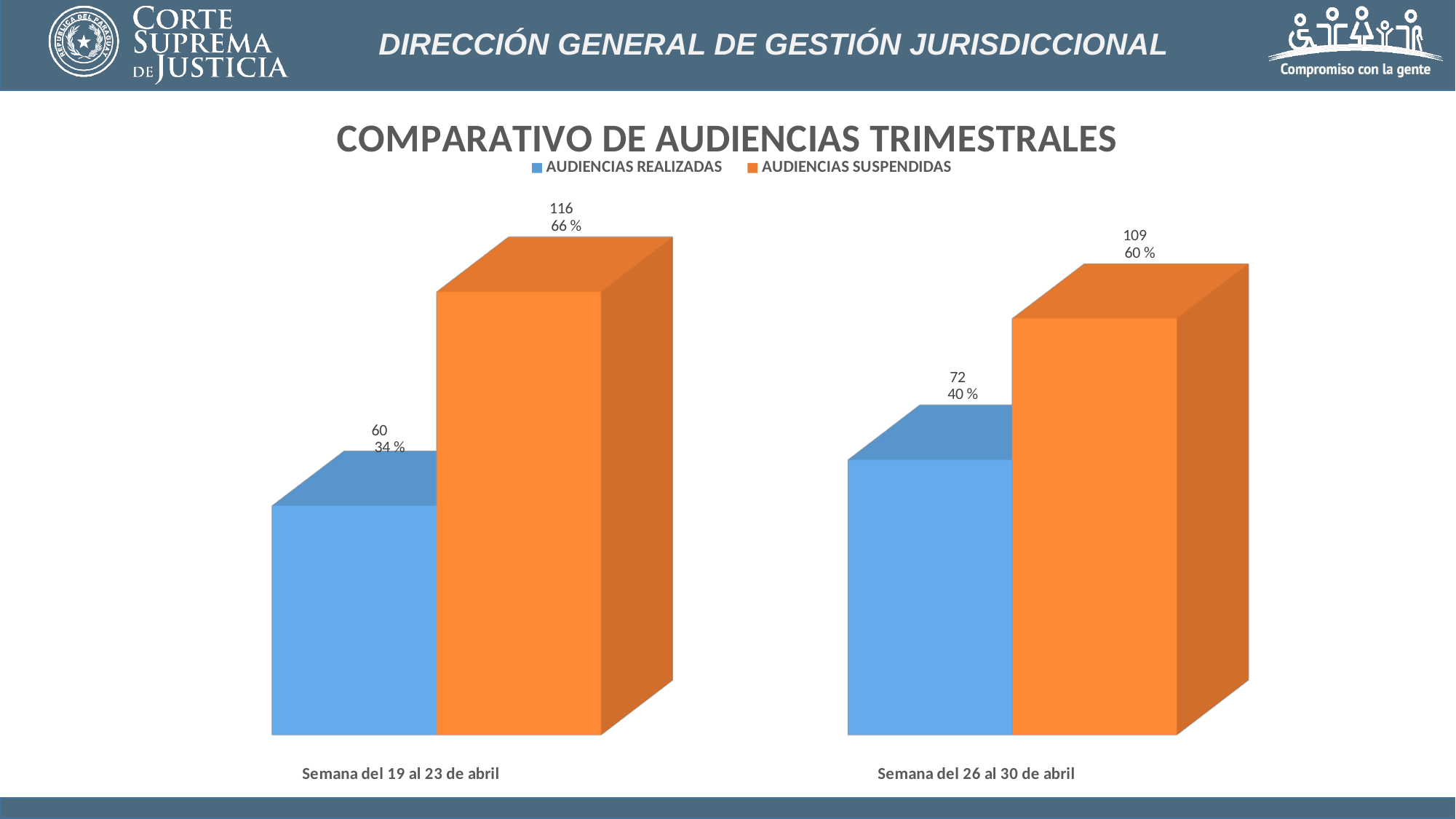
What is the value for AUDIENCIAS SUSPENDIDAS in the week 'Semana del 19 al 23 de abril'? 116 What is the value for AUDIENCIAS REALIZADAS in the week 'Semana del 26 al 30 de abril'? 72 What is the value for AUDIENCIAS REALIZADAS in the week 'Semana del 19 al 23 de abril'? 60 What percentage is shown for AUDIENCIAS SUSPENDIDAS in the week 'Semana del 26 al 30 de abril'? 60 % Which week has the highest value for AUDIENCIAS SUSPENDIDAS? Semana del 19 al 23 de abril Which is larger in the week 'Semana del 26 al 30 de abril': AUDIENCIAS REALIZADAS or AUDIENCIAS SUSPENDIDAS? AUDIENCIAS SUSPENDIDAS What is the difference between AUDIENCIAS SUSPENDIDAS and AUDIENCIAS REALIZADAS in the week 'Semana del 19 al 23 de abril'? 56 Which week has the lowest value for AUDIENCIAS REALIZADAS? Semana del 19 al 23 de abril How many series does the legend list? 2 What is the value for AUDIENCIAS SUSPENDIDAS in the week 'Semana del 26 al 30 de abril'? 109 How many weeks (categories) are shown on the chart? 2 What is the title of the chart? COMPARATIVO DE AUDIENCIAS TRIMESTRALES